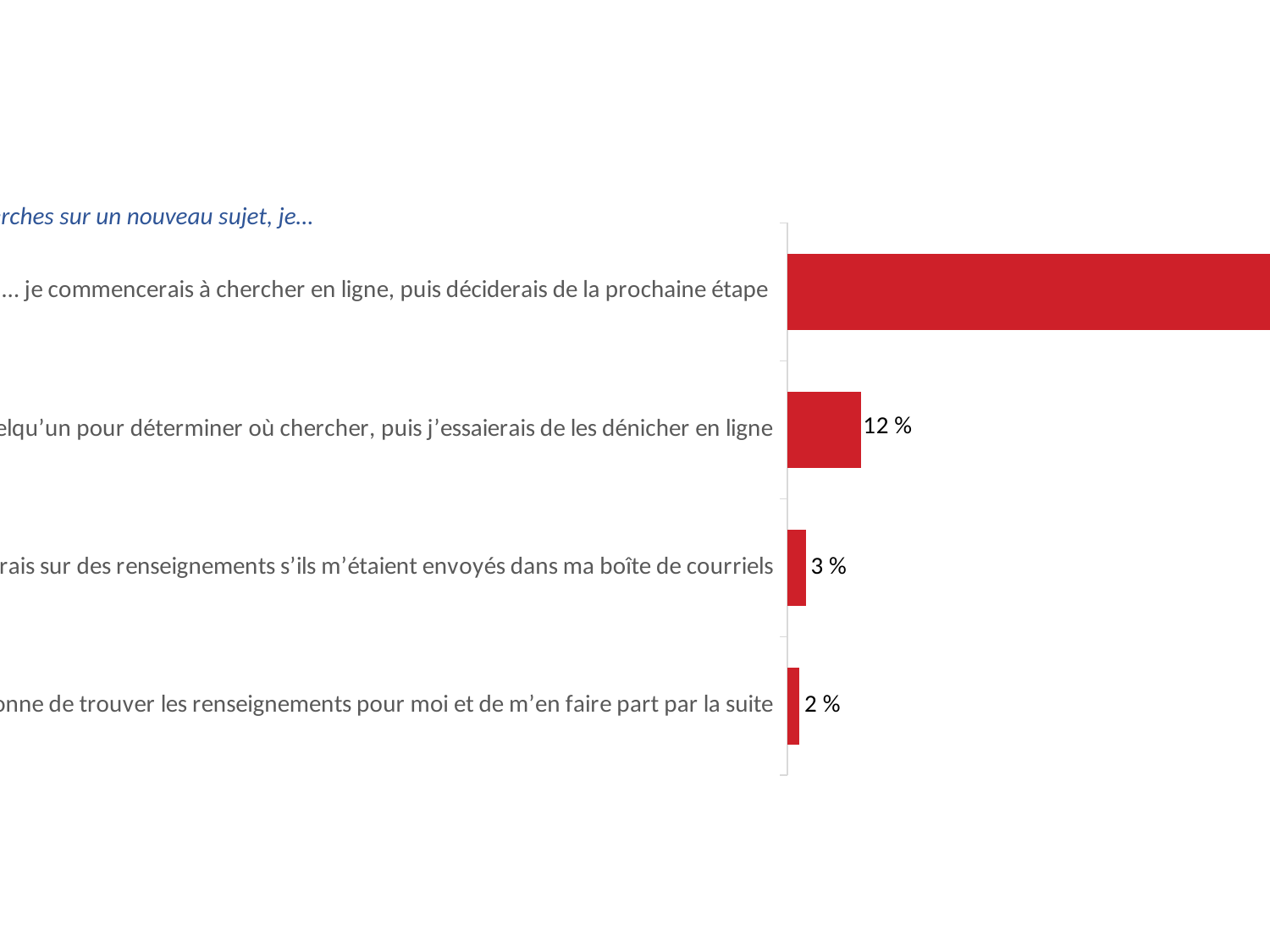
How many categories are shown in the chart? 4 What is the difference between the value for the category ending "dénicher en ligne" and the category ending "boîte de courriels"? 9 % Which category has the longest bar? … je commencerais à chercher en ligne, puis déciderais de la prochaine étape Which category has the shortest bar? …onne de trouver les renseignements pour moi et de m'en faire part par la suite What kind of chart is shown on the slide? Bar chart What is the value for the category ending "puis j'essaierais de les dénicher en ligne"? 12 % What is the value for the category ending "envoyés dans ma boîte de courriels"? 3 % Which is larger: the value for the category ending "dénicher en ligne" or the category ending "boîte de courriels"? The category ending "dénicher en ligne" What is the difference between the value for the category ending "boîte de courriels" and the category ending "par la suite"? 1 % What is the difference between the value for the category ending "dénicher en ligne" and the category ending "par la suite"? 10 % What colour are the bars in the chart? Red What is the value for the category ending "de m'en faire part par la suite"? 2 %